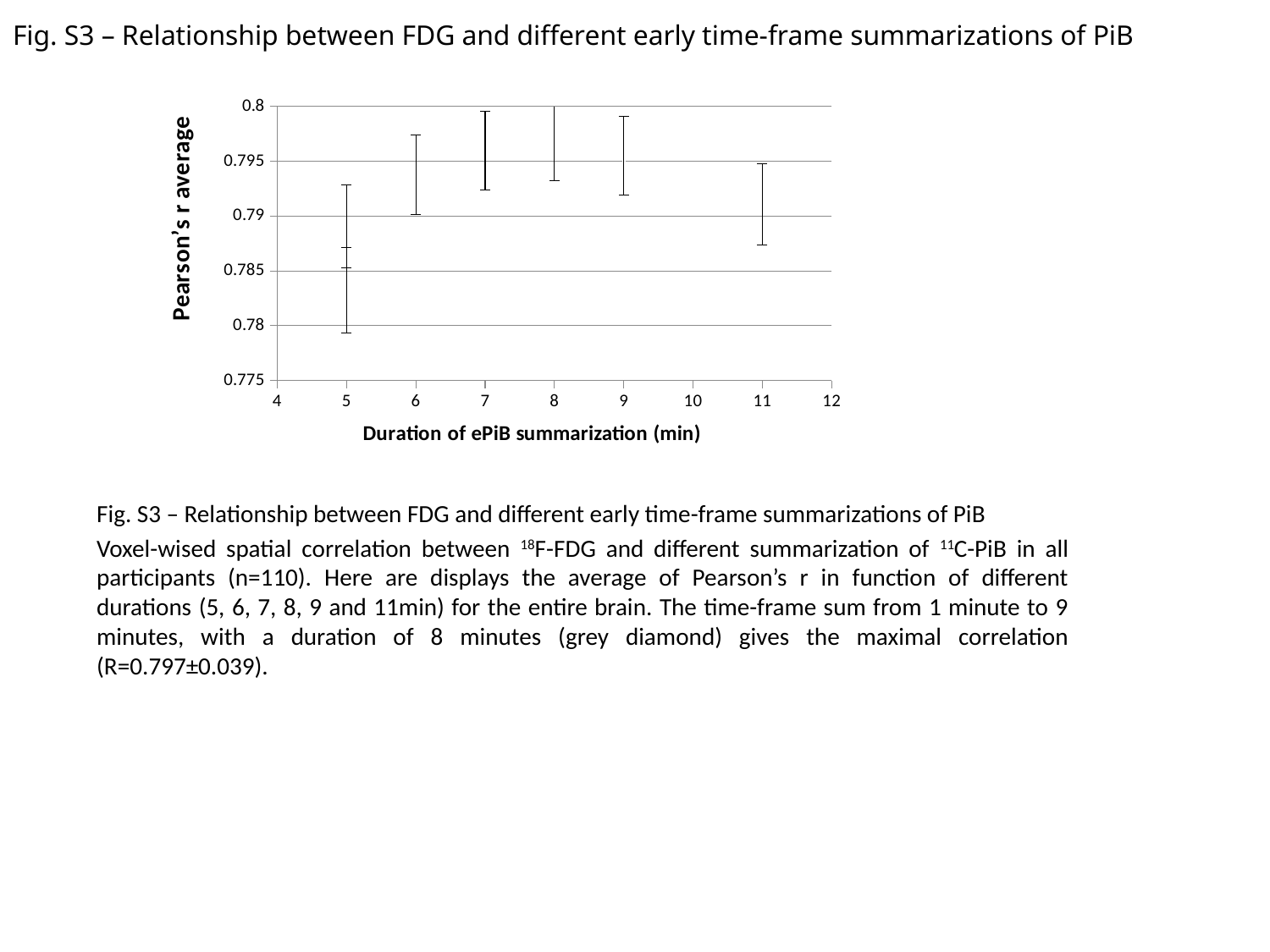
What is the label of the y axis of the chart? Pearson's r average What is the largest duration shown on the x axis of the chart? 12 What is the highest value shown on the y axis of the chart? 0.8 Is there a data point plotted at a duration of 10 min on the chart? No What is the label of the x axis of the chart? Duration of ePiB summarization (min) How many durations have data points plotted on the chart? 6 What is the lowest value shown on the y axis of the chart? 0.775 At which durations (in min) are data points plotted on the chart? 5, 6, 7, 8, 9 and 11 Does the error bar at a duration of 5 min extend below 0.78 on the chart? Yes Does the error bar at a duration of 8 min extend below 0.79 on the chart? No